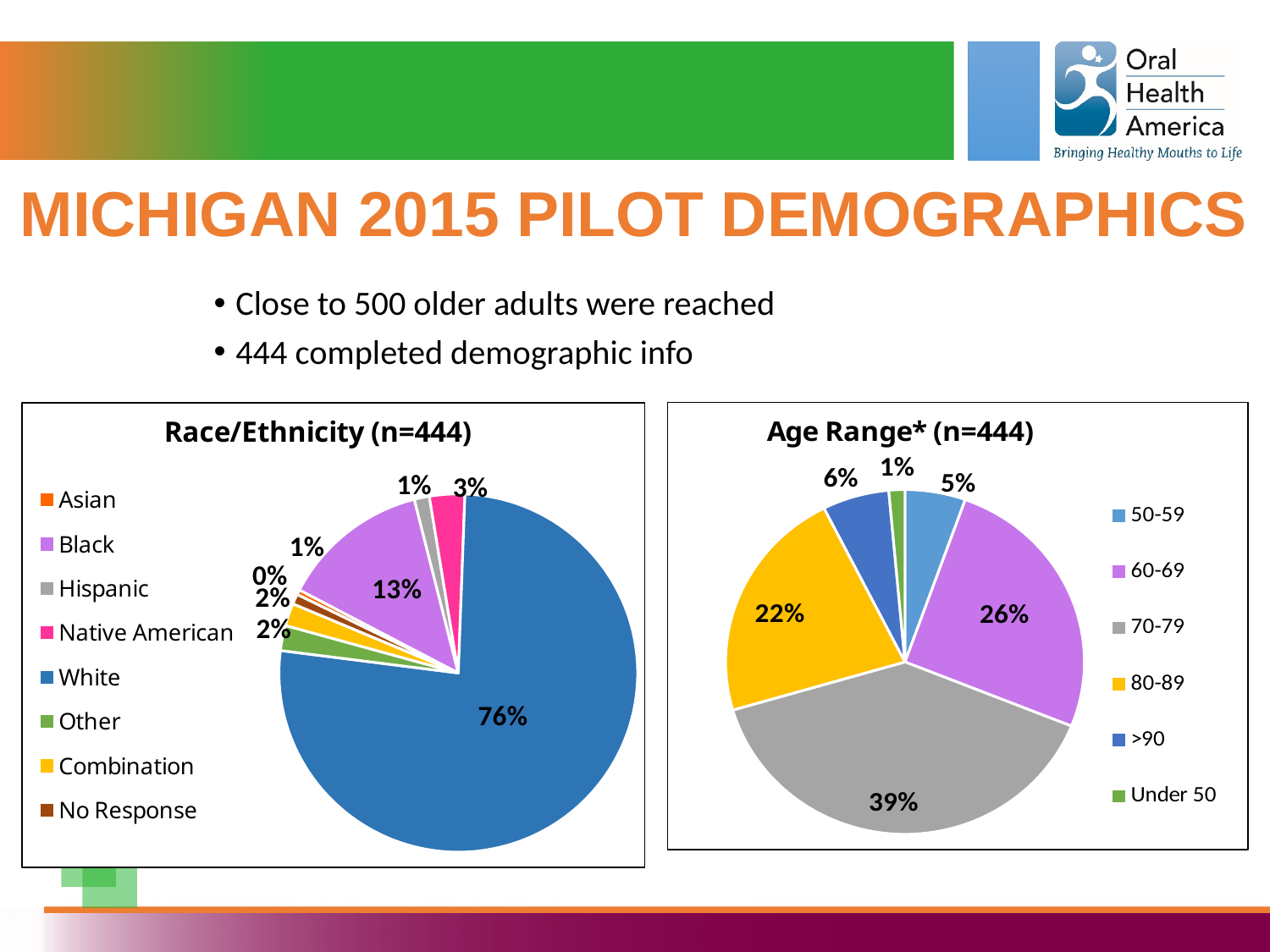
In the Race/Ethnicity (n=444) chart, what share of respondents are White? 76% In the Race/Ethnicity (n=444) chart, how many categories does the legend list? 8 In the Age Range* (n=444) chart, what share of respondents are aged 70-79? 39% In the Race/Ethnicity (n=444) chart, what is the value for Black? 13% In the Age Range* (n=444) chart, what is the value for the >90 group? 6% In the Age Range* (n=444) chart, which age range has the largest share? 70-79 In the Race/Ethnicity (n=444) chart, which is larger, the share for Black or the share for Native American? Black In the Age Range* (n=444) chart, what is the difference in percentage points between the 60-69 and 80-89 groups? 4 percentage points What type of chart is the Race/Ethnicity (n=444) chart? Pie chart In the Age Range* (n=444) chart, which age range has the smallest share? Under 50 In the Age Range* (n=444) chart, how many age ranges are shown? 6 In the Race/Ethnicity (n=444) chart, what is the difference in percentage points between White and Black? 63 percentage points